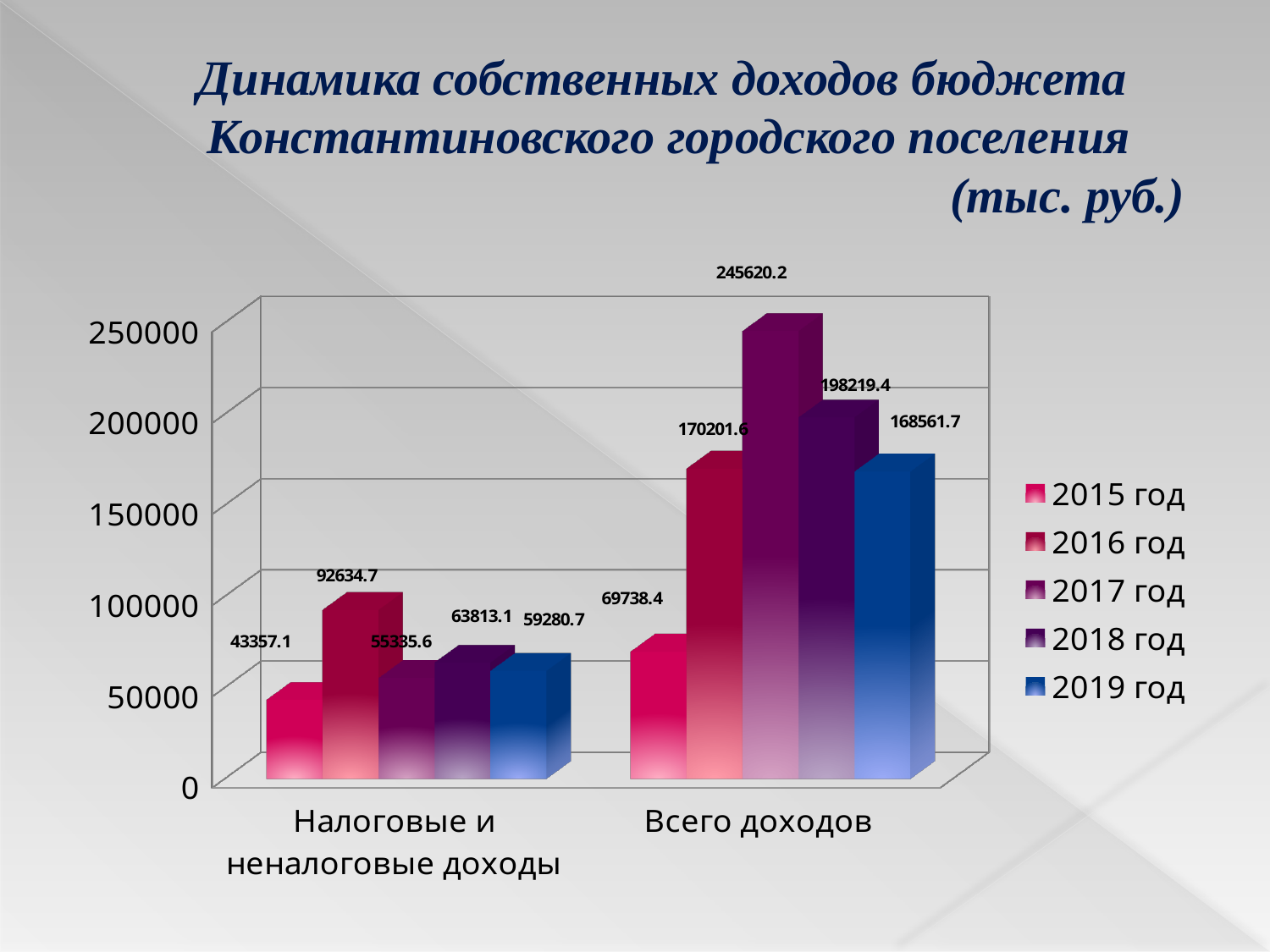
How many series does the legend list? 5 What is the value for 2015 год in the Налоговые и неналоговые доходы category? 43357.1 What is the value for 2017 год in the Всего доходов category? 245620.2 What kind of chart is shown on the slide? bar chart What is the value for 2016 год in the Налоговые и неналоговые доходы category? 92634.7 Which year has the highest value in the Всего доходов category? 2017 год How many categories are shown on the x axis? 2 Which year has the lowest value in the Налоговые и неналоговые доходы category? 2015 год What is the value for 2019 год in the Всего доходов category? 168561.7 What is the difference between the 2017 год and 2018 год values in the Всего доходов category? 47400.8 Which is larger in the Налоговые и неналоговые доходы category: the value for 2018 год or the value for 2019 год? 2018 год Is the value for 2016 год in the Всего доходов category greater or less than 150000? greater